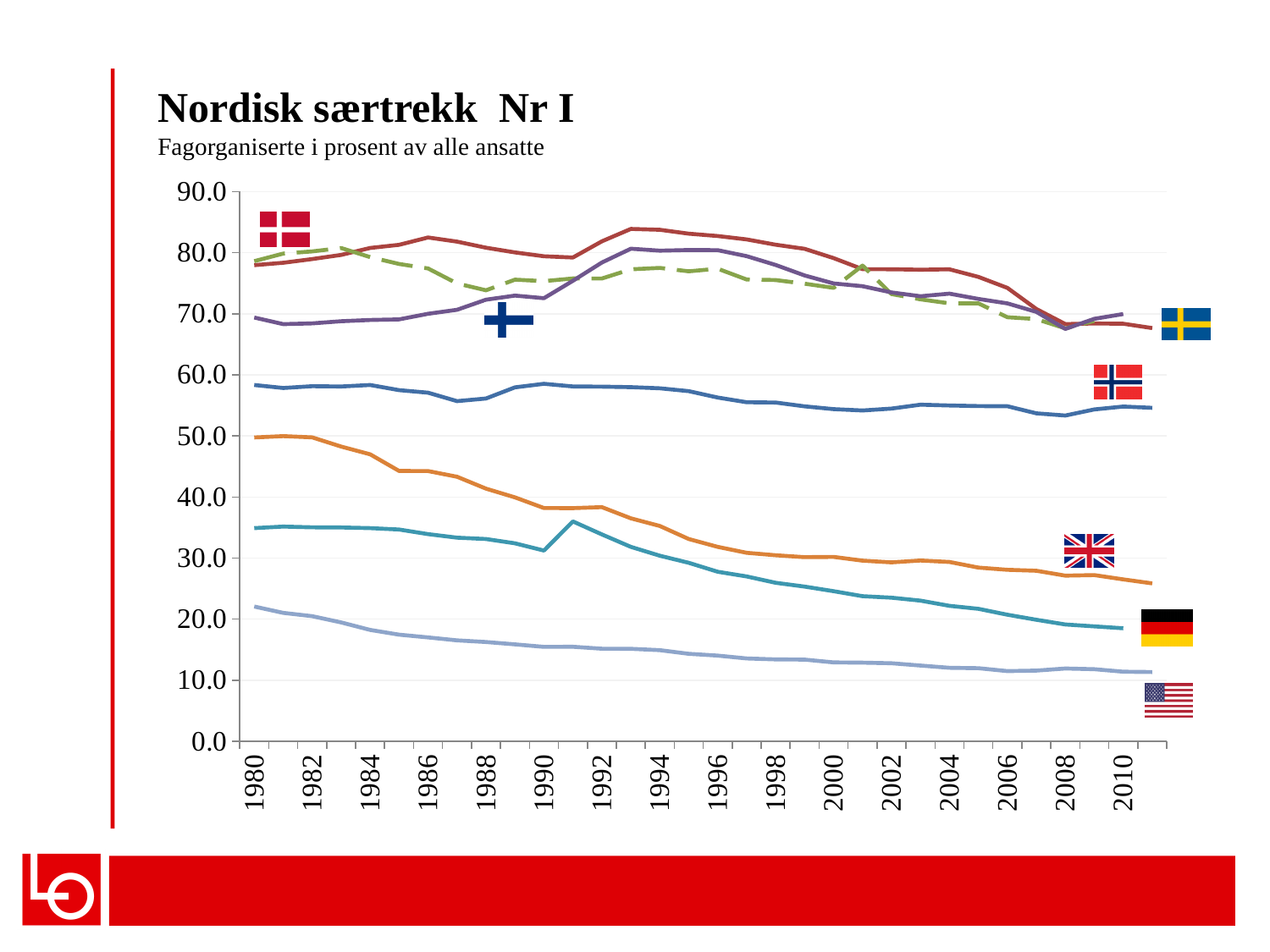
Does the line marked with the UK flag rise or fall from 1980 to 2010? fall Is the value of the line marked with the Norwegian flag in 1980 greater or less than 50? greater Is the value of the line marked with the UK flag in 1980 greater or less than 40? greater In 2010, which is higher: the line marked with the Norwegian flag or the line marked with the UK flag? the line marked with the Norwegian flag How many year labels are shown along the x axis? 16 Is the value of the line marked with the US flag in 2010 greater or less than 20? less Which line is the lowest across the whole chart: the one marked with the US flag or the one marked with the German flag? the one marked with the US flag What is the title of the slide above the chart? Nordisk særtrekk Nr I What is the subtitle printed under the slide title describing the chart? Fagorganiserte i prosent av alle ansatte What kind of chart is shown on the slide? line chart